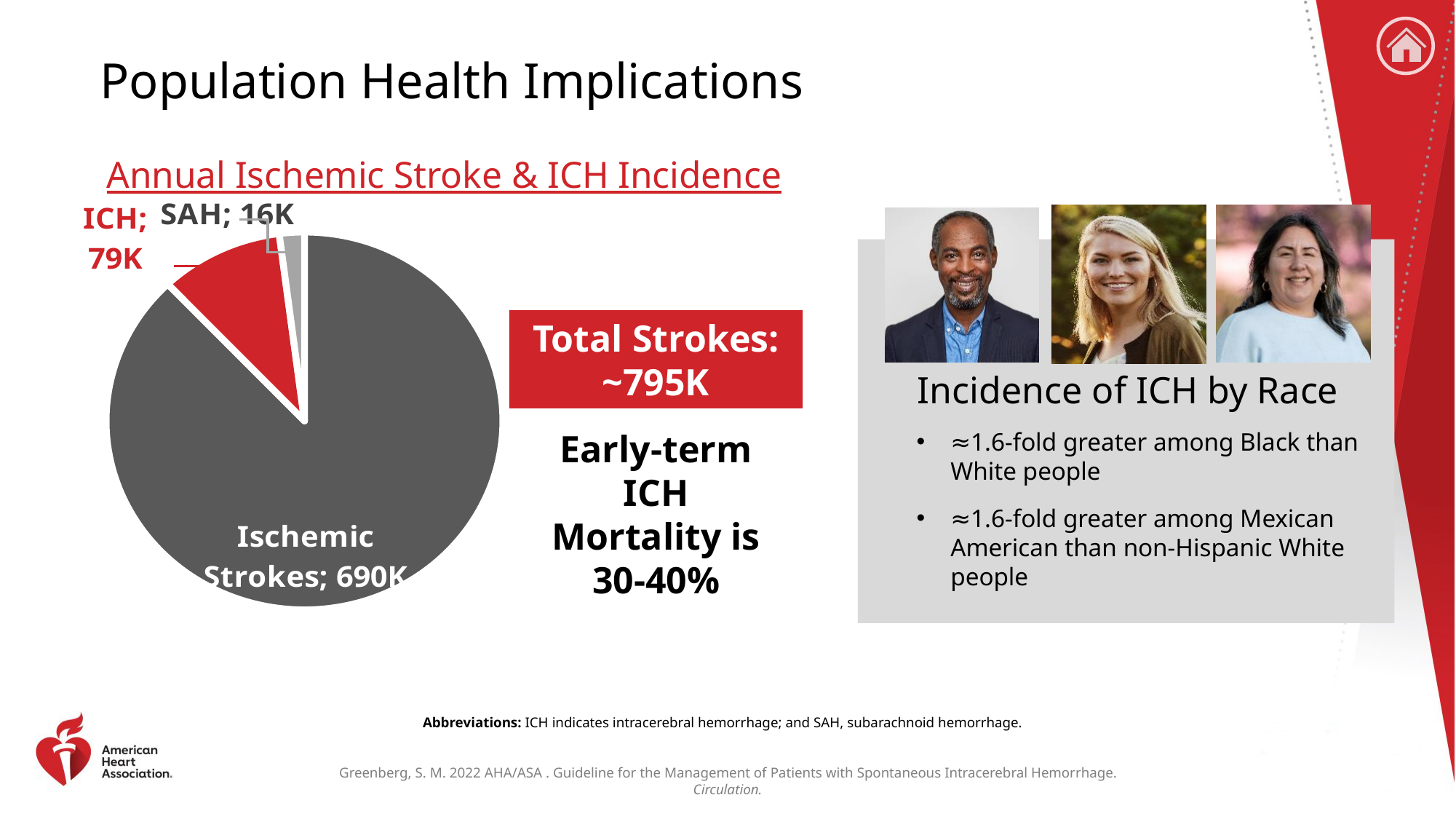
What is the difference between the Ischemic Strokes value and the ICH value in the pie chart? 611K What kind of chart is shown under the title "Annual Ischemic Stroke & ICH Incidence"? Pie chart Which category has the smallest slice in the pie chart? SAH What is the difference between the ICH value and the SAH value in the pie chart? 63K How many slices does the pie chart have? 3 What is the value shown for ICH in the pie chart? 79K What is the value shown for Ischemic Strokes in the pie chart? 690K What is the title of the pie chart? Annual Ischemic Stroke & ICH Incidence What is the value shown for SAH in the pie chart? 16K What colour is the ICH slice in the pie chart? Red Which category has the largest slice in the pie chart? Ischemic Strokes In the pie chart, which is larger, ICH or SAH? ICH